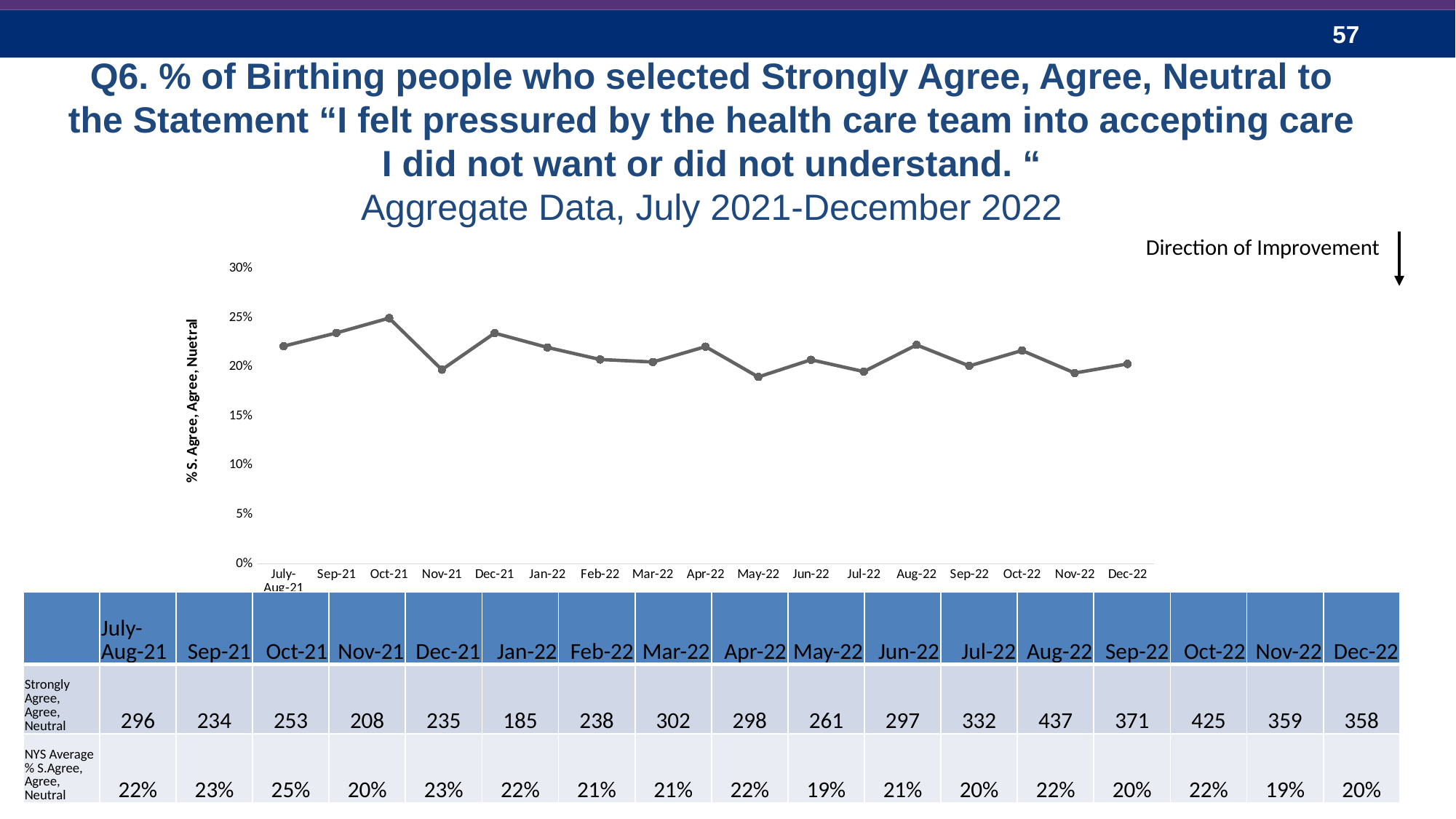
What is the NYS average % S.Agree, Agree, Neutral for Oct-21? 25% How many data points are plotted on the line chart? 17 Is the value for Nov-22 greater or less than 25%? less What is the NYS average % S.Agree, Agree, Neutral for Dec-22? 20% What is the difference between the NYS average % for Oct-21 and Nov-21? 5% Is the value for Oct-21 greater or less than 20%? greater Which month has the highest NYS average % S.Agree, Agree, Neutral? Oct-21 Does the line rise or fall from Oct-21 to Nov-21? fall Which is larger, the NYS average % for Sep-21 or for Sep-22? Sep-21 What is the NYS average % S.Agree, Agree, Neutral for May-22? 19% What kind of chart is shown on the slide? line chart What is the label on the vertical axis of the chart? % S. Agree, Agree, Nuetral